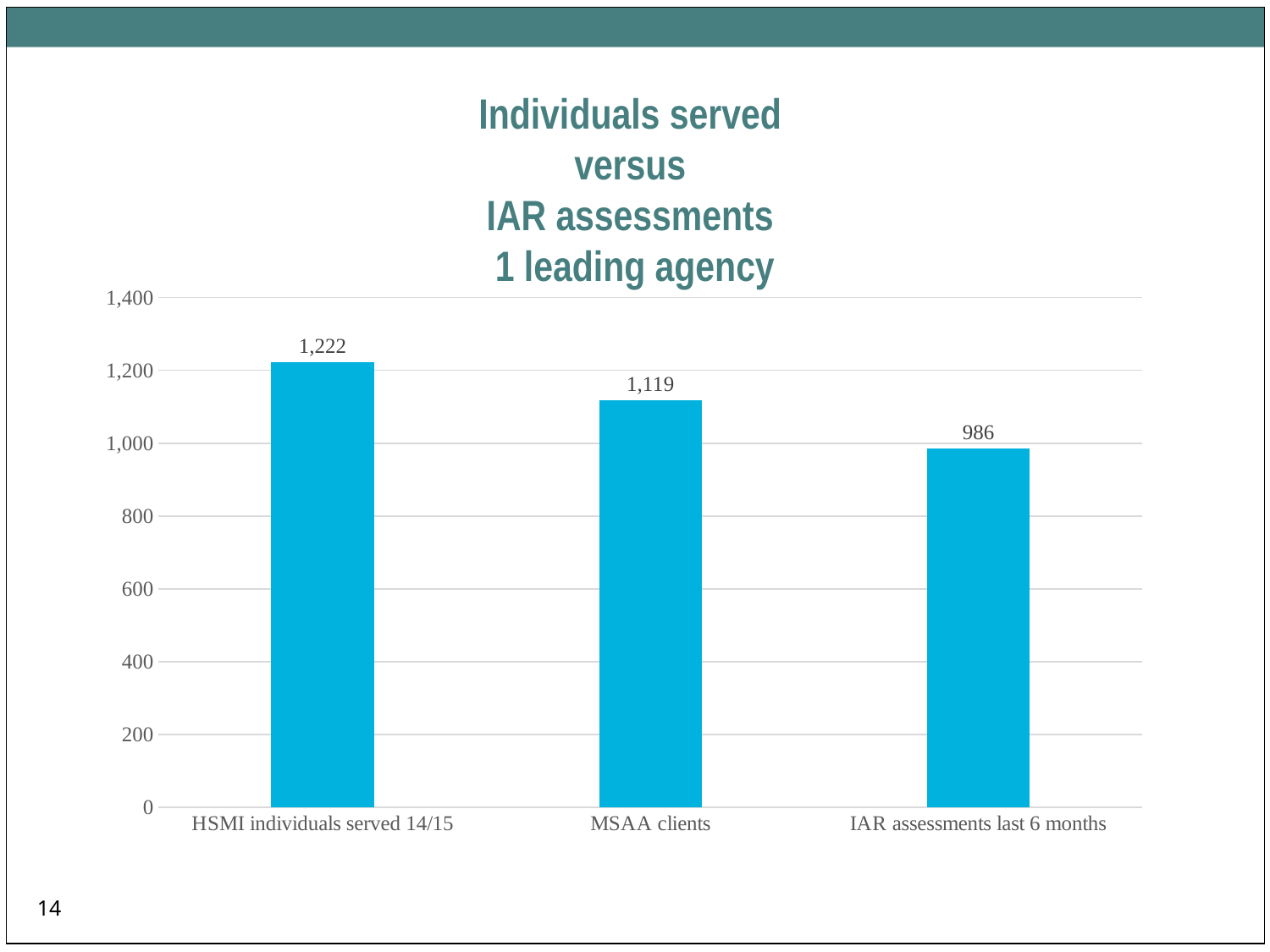
Is the value for IAR assessments last 6 months greater or less than 1,000? less How many categories are shown in the chart? 3 Do the values rise or fall from left to right across the categories? fall Which category has the lowest value? IAR assessments last 6 months What is the value for MSAA clients? 1,119 What is the difference between MSAA clients and IAR assessments last 6 months? 133 Which is larger, MSAA clients or IAR assessments last 6 months? MSAA clients What is the difference between HSMI individuals served 14/15 and MSAA clients? 103 What is the value for HSMI individuals served 14/15? 1,222 What kind of chart is shown on the slide? bar chart Which category has the highest value? HSMI individuals served 14/15 What is the value for IAR assessments last 6 months? 986